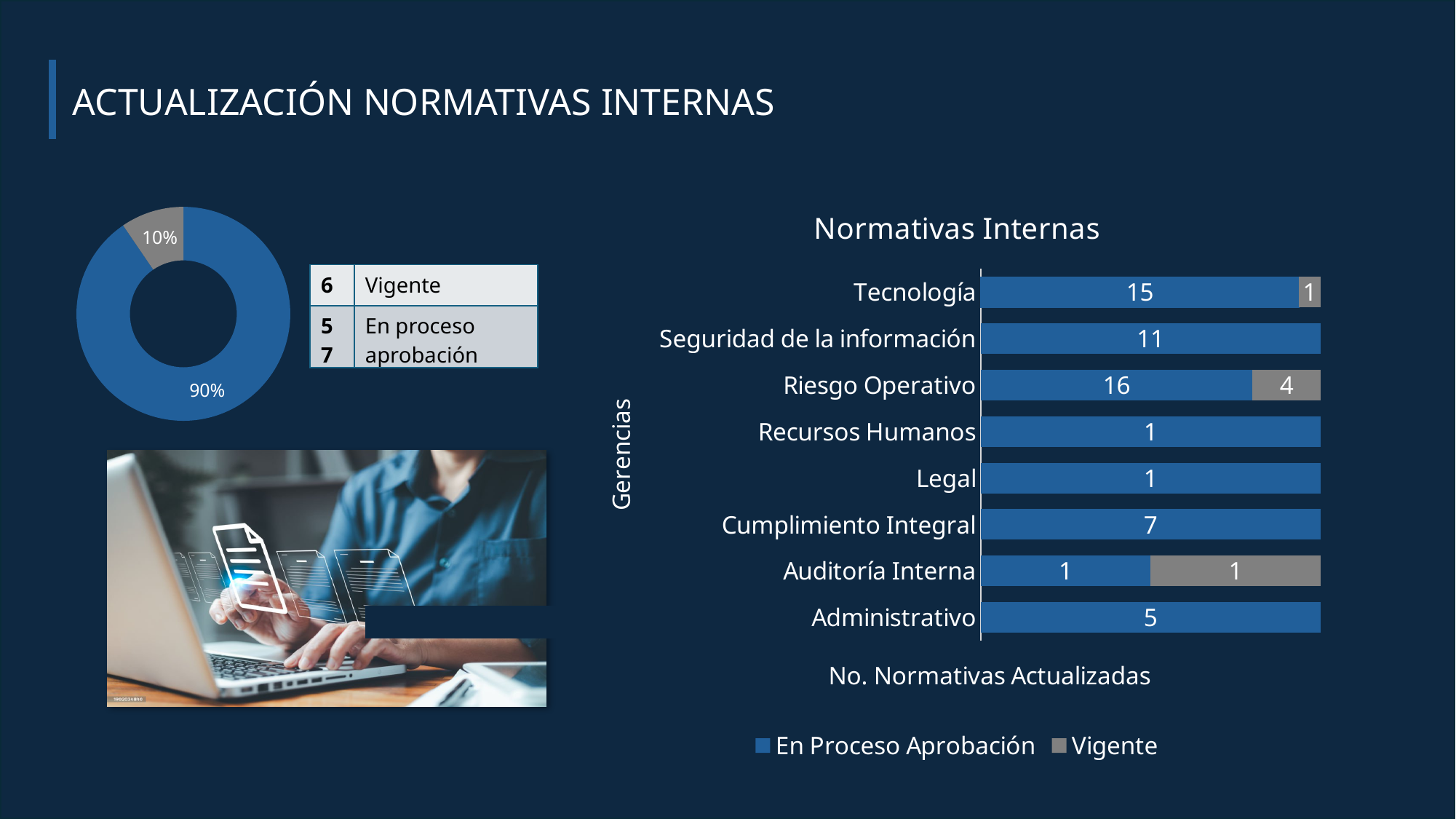
In the 'Normativas Internas' bar chart, what is the value shown for Seguridad de la información? 11 How many series does the legend of the 'Normativas Internas' chart list? 2 In the 'Normativas Internas' bar chart, what is the total of the stacked bar for Riesgo Operativo? 20 In the 'Normativas Internas' bar chart, what is the 'En Proceso Aprobación' value for Riesgo Operativo? 16 In the 'Normativas Internas' bar chart, which category has the highest 'En Proceso Aprobación' value? Riesgo Operativo In the 'Normativas Internas' bar chart, what is the difference between the 'En Proceso Aprobación' values for Tecnología and Administrativo? 10 How many categories (gerencias) are shown in the 'Normativas Internas' bar chart? 8 In the 'Normativas Internas' bar chart, which is larger: the 'En Proceso Aprobación' value for Seguridad de la información or for Cumplimiento Integral? Seguridad de la información In the 'Normativas Internas' bar chart, what is the 'Vigente' value for Tecnología? 1 What type of chart is the 'Normativas Internas' chart on the right of the slide? Bar chart In the 'Normativas Internas' bar chart, what is the value shown for Cumplimiento Integral? 7 In the donut chart on the left of the slide, what percentage is shown for the larger (blue) slice? 90%